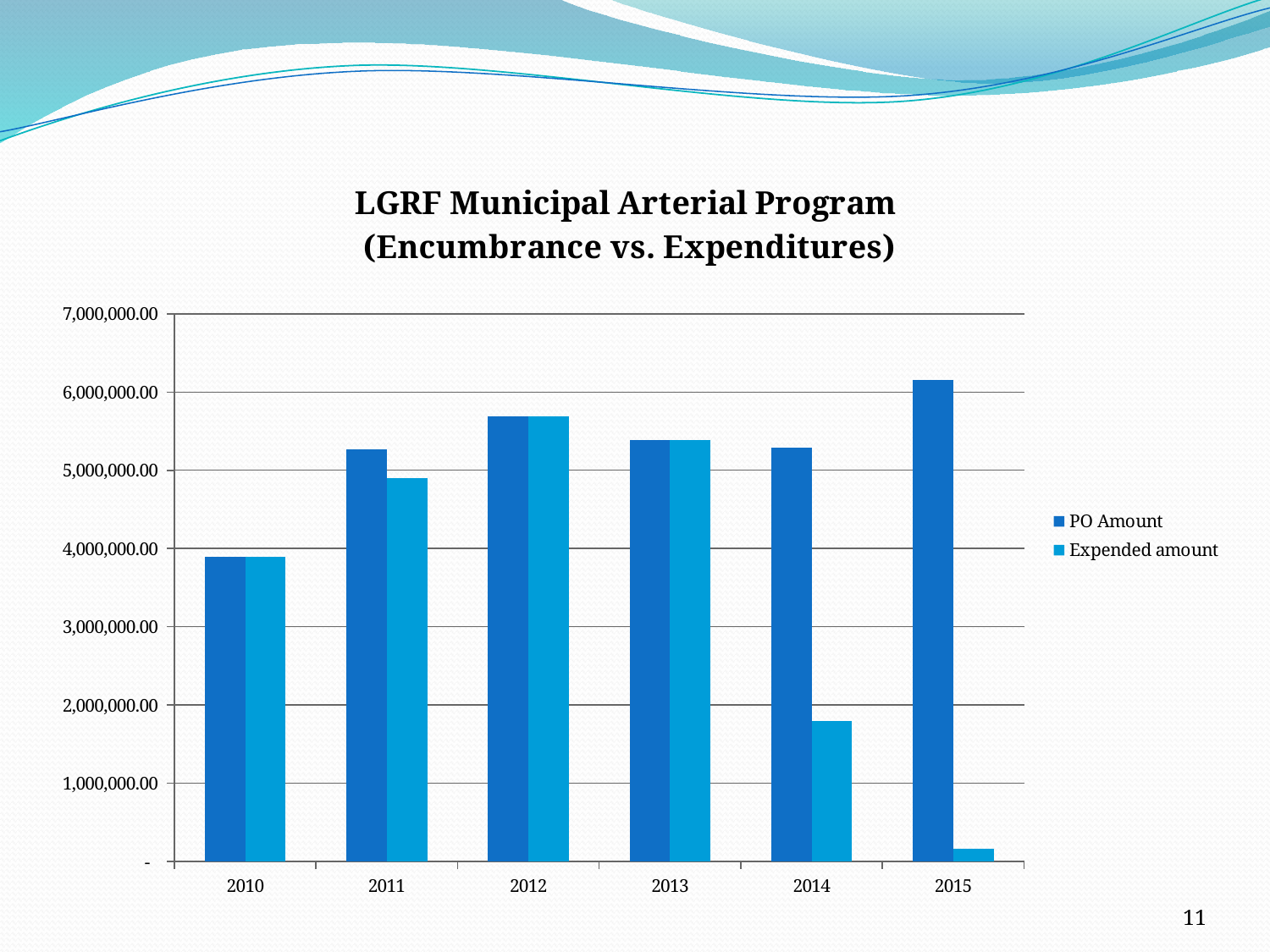
Is the Expended amount for 2015 greater or less than 1,000,000.00? less Which year has the lowest PO Amount? 2010 How many series does the legend list? 2 Is the Expended amount for 2014 greater or less than 2,000,000.00? less What kind of chart is shown on the slide? Bar chart Does the Expended amount rise or fall from 2013 to 2015? Fall Is the PO Amount for 2010 greater or less than 4,000,000.00? less Which year has the highest PO Amount? 2015 How many years are shown on the x axis? 6 In 2014, which is larger, the PO Amount or the Expended amount? PO Amount Which year has the lowest Expended amount? 2015